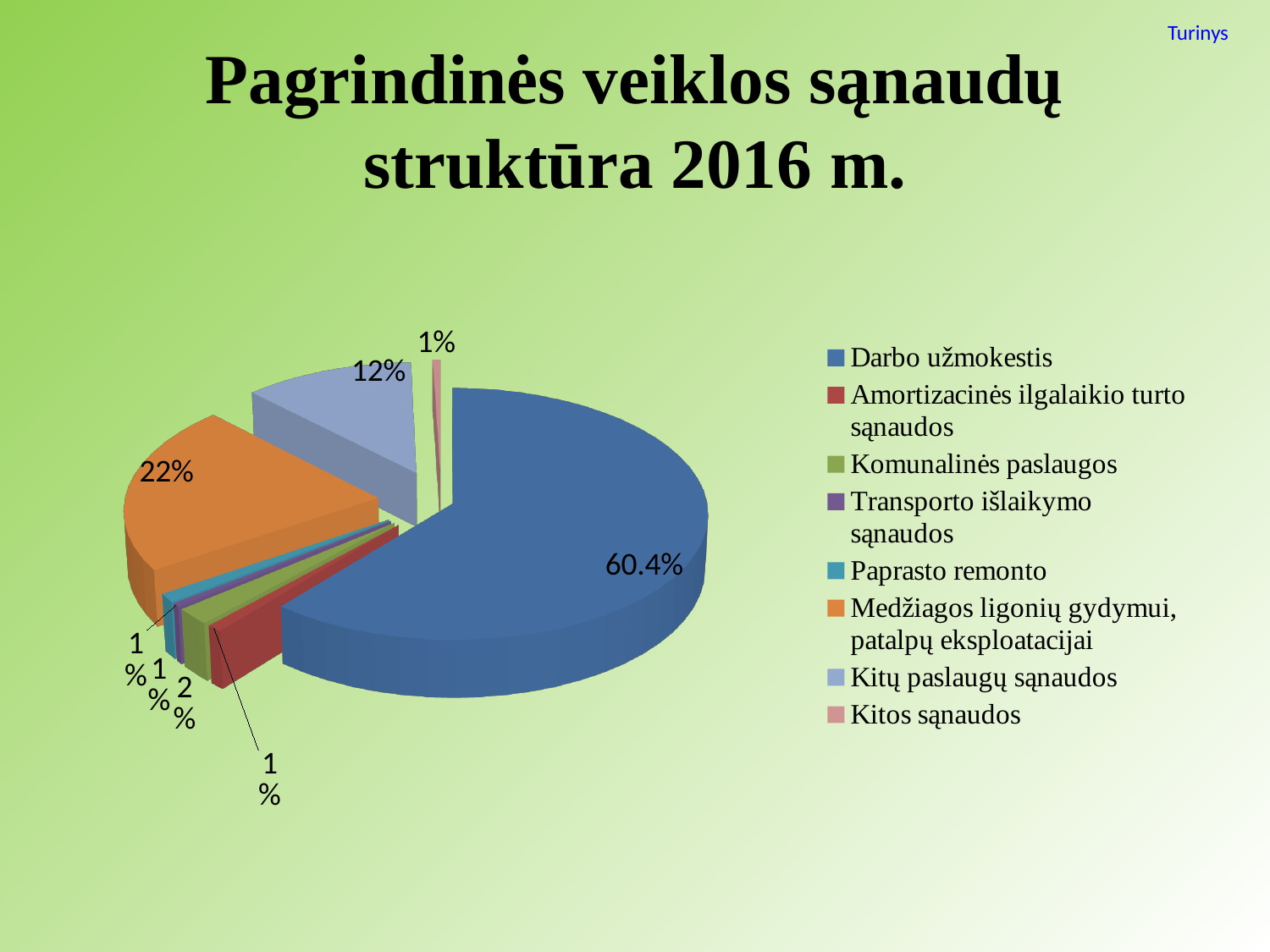
What percentage is shown for Kitos sąnaudos? 1% What is the title of the slide? Pagrindinės veiklos sąnaudų struktūra 2016 m. What share of the pie does Darbo užmokestis account for? 60.4% What percentage is shown for Kitų paslaugų sąnaudos? 12% How many categories does the legend list? 8 Which category has the largest share of the pie? Darbo užmokestis By how many percentage points does the share for Medžiagos ligonių gydymui, patalpų eksploatacijai exceed the share for Kitų paslaugų sąnaudos? 10 percentage points What percentage is shown for Komunalinės paslaugos? 2% What percentage is shown for Medžiagos ligonių gydymui, patalpų eksploatacijai? 22% What type of chart is shown on the slide? Pie chart Which is larger: the share for Medžiagos ligonių gydymui, patalpų eksploatacijai or the share for Kitų paslaugų sąnaudos? Medžiagos ligonių gydymui, patalpų eksploatacijai Which colour represents Darbo užmokestis in the legend? Blue